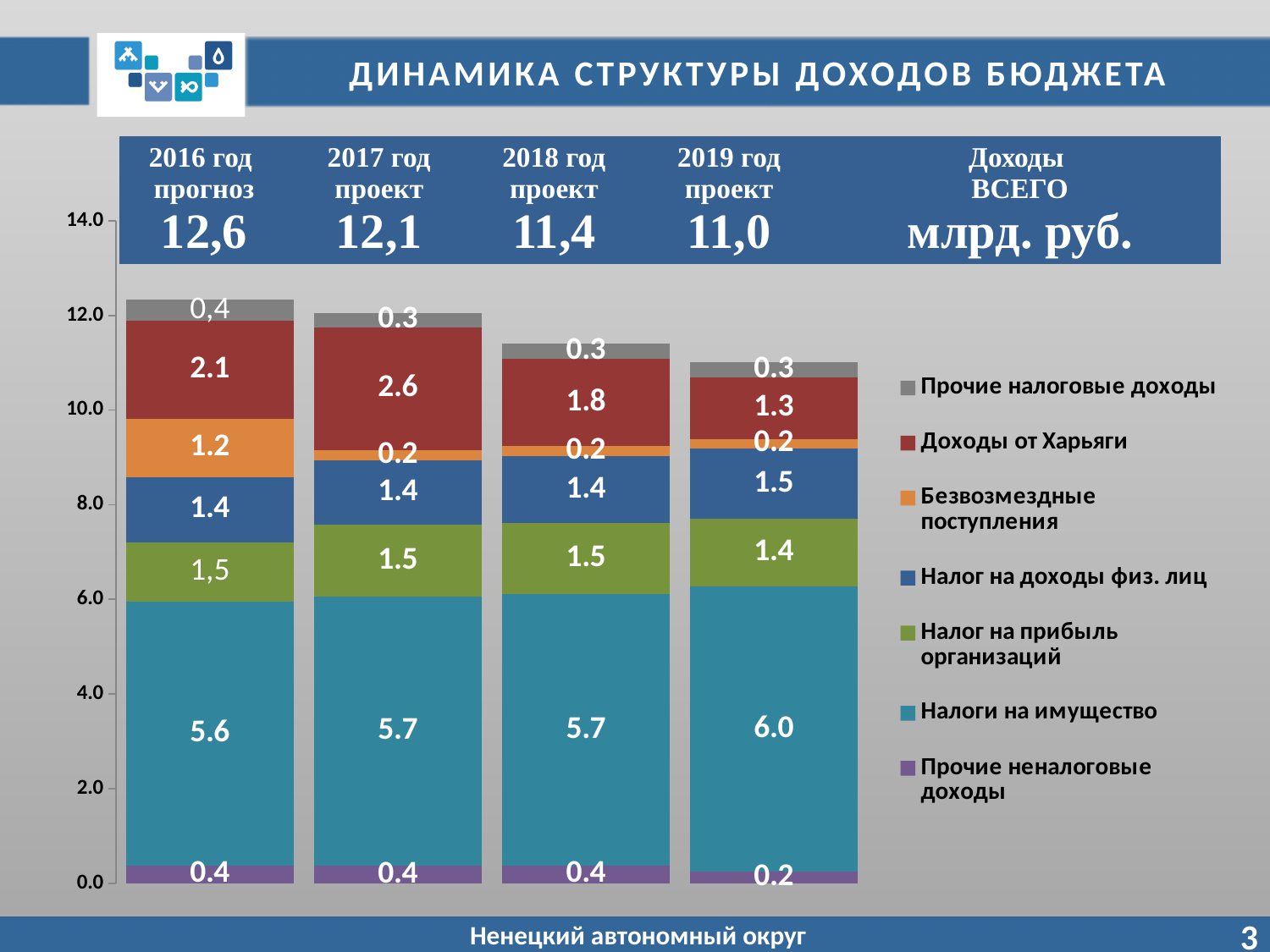
How many bars (years) are plotted in the chart? 4 What is the value of Доходы от Харьяги for 2017 год проект? 2.6 How many series does the legend list? 7 What is the value of Безвозмездные поступления for 2016 год прогноз? 1.2 What kind of chart is shown on the slide? Stacked bar chart In which year is Прочие неналоговые доходы the lowest? 2019 год проект What is the total of the stacked bar for 2016 год прогноз (Доходы ВСЕГО)? 12,6 Do the total revenues (Доходы ВСЕГО) rise or fall from 2016 to 2019? Fall What is the value of Налоги на имущество for 2019 год проект? 6.0 What is the difference between Доходы от Харьяги in 2016 год прогноз and 2019 год проект? 0.8 Which is larger: Налоги на имущество in 2016 год прогноз or in 2019 год проект? 2019 год проект In which year is Доходы от Харьяги the highest? 2017 год проект